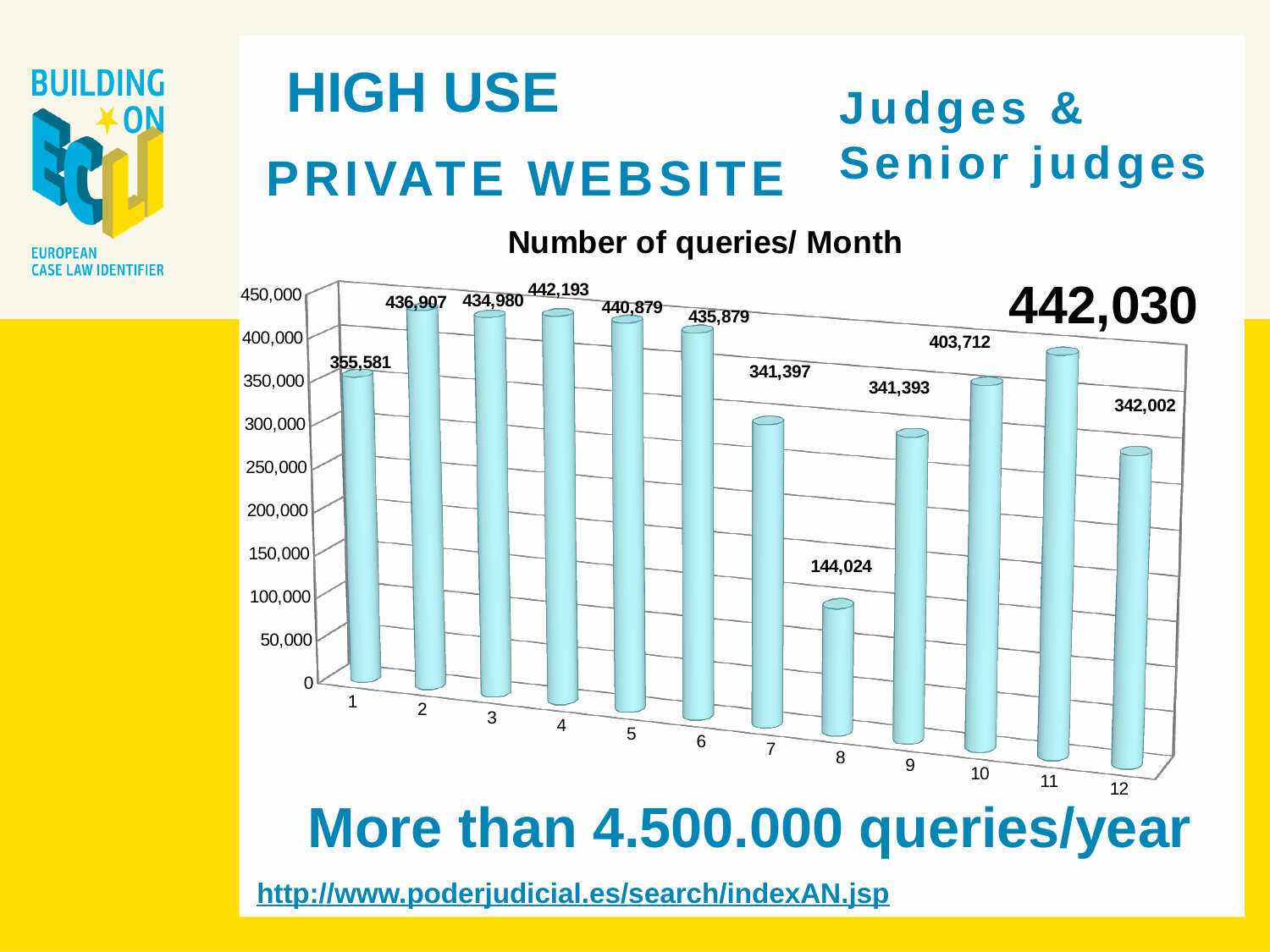
What is the number of queries for month 1? 355,581 What is the title of the chart? Number of queries/ Month Which month has more queries, month 2 or month 7? month 2 Is the value for month 5 greater or less than 400,000? greater Is the value for month 9 greater or less than 350,000? less What is the number of queries for month 8? 144,024 What is the number of queries for month 10? 403,712 Which month has the lowest number of queries? 8 What type of chart is shown on the slide? bar chart What is the difference in queries between month 4 and month 8? 298,169 What is the number of queries for month 11? 442,030 How many months (categories) are plotted in the chart? 12